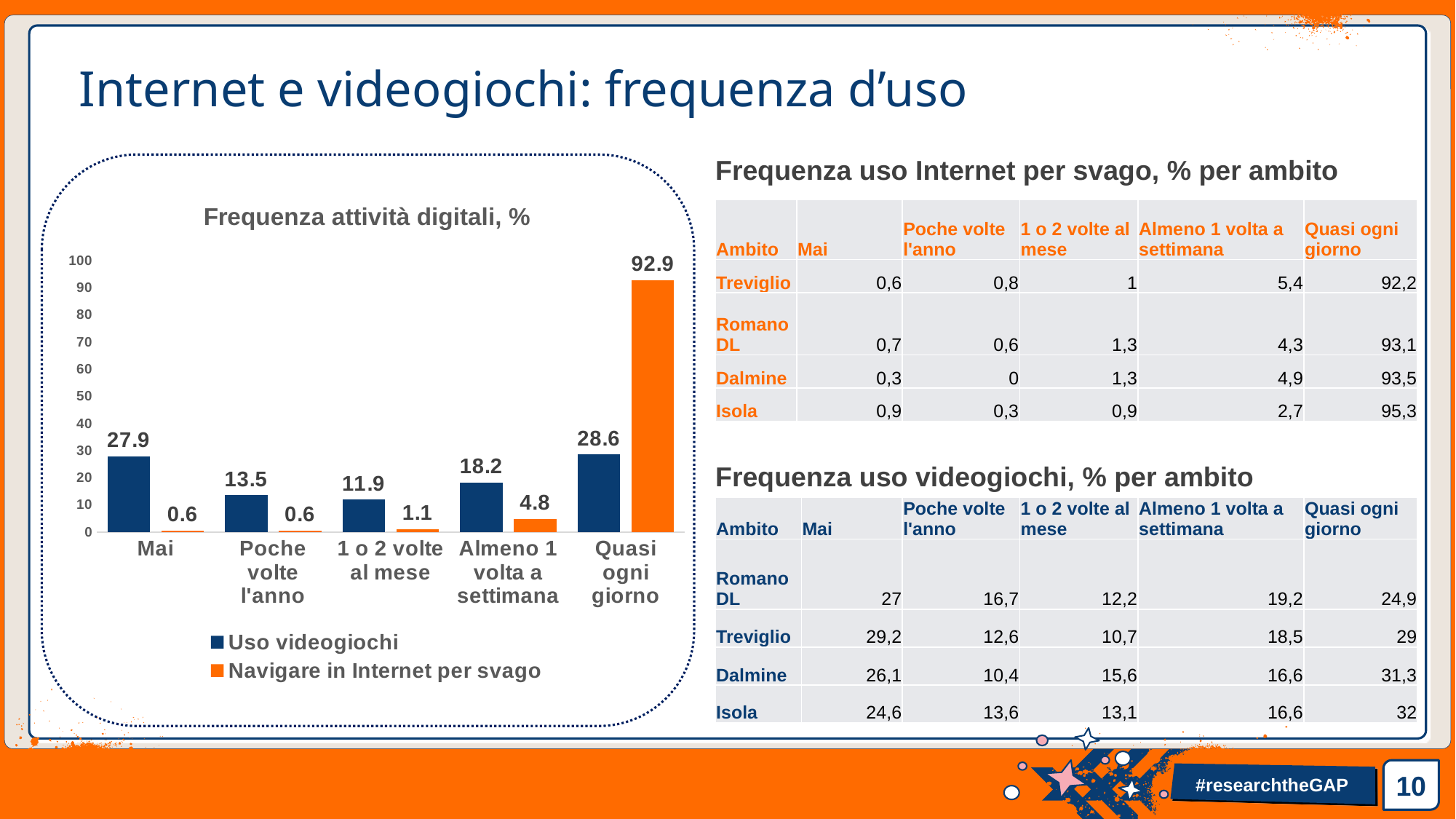
What kind of chart is shown on the slide? bar chart Which category has the highest value for 'Uso videogiochi'? Quasi ogni giorno How many categories are shown on the x axis of the chart? 5 How many series does the chart's legend list? 2 Which category has the lowest value for 'Uso videogiochi'? 1 o 2 volte al mese What is the value for 'Navigare in Internet per svago' in the 'Almeno 1 volta a settimana' category? 4.8 What is the value for 'Uso videogiochi' in the 'Mai' category? 27.9 What is the value for 'Navigare in Internet per svago' in the 'Quasi ogni giorno' category? 92.9 In the 'Poche volte l'anno' category, which series has the larger value, 'Uso videogiochi' or 'Navigare in Internet per svago'? Uso videogiochi What is the difference between 'Navigare in Internet per svago' and 'Uso videogiochi' in the 'Quasi ogni giorno' category? 64.3 Is the value for 'Uso videogiochi' in the 'Almeno 1 volta a settimana' category greater or less than 20? less What is the title of the chart? Frequenza attività digitali, %